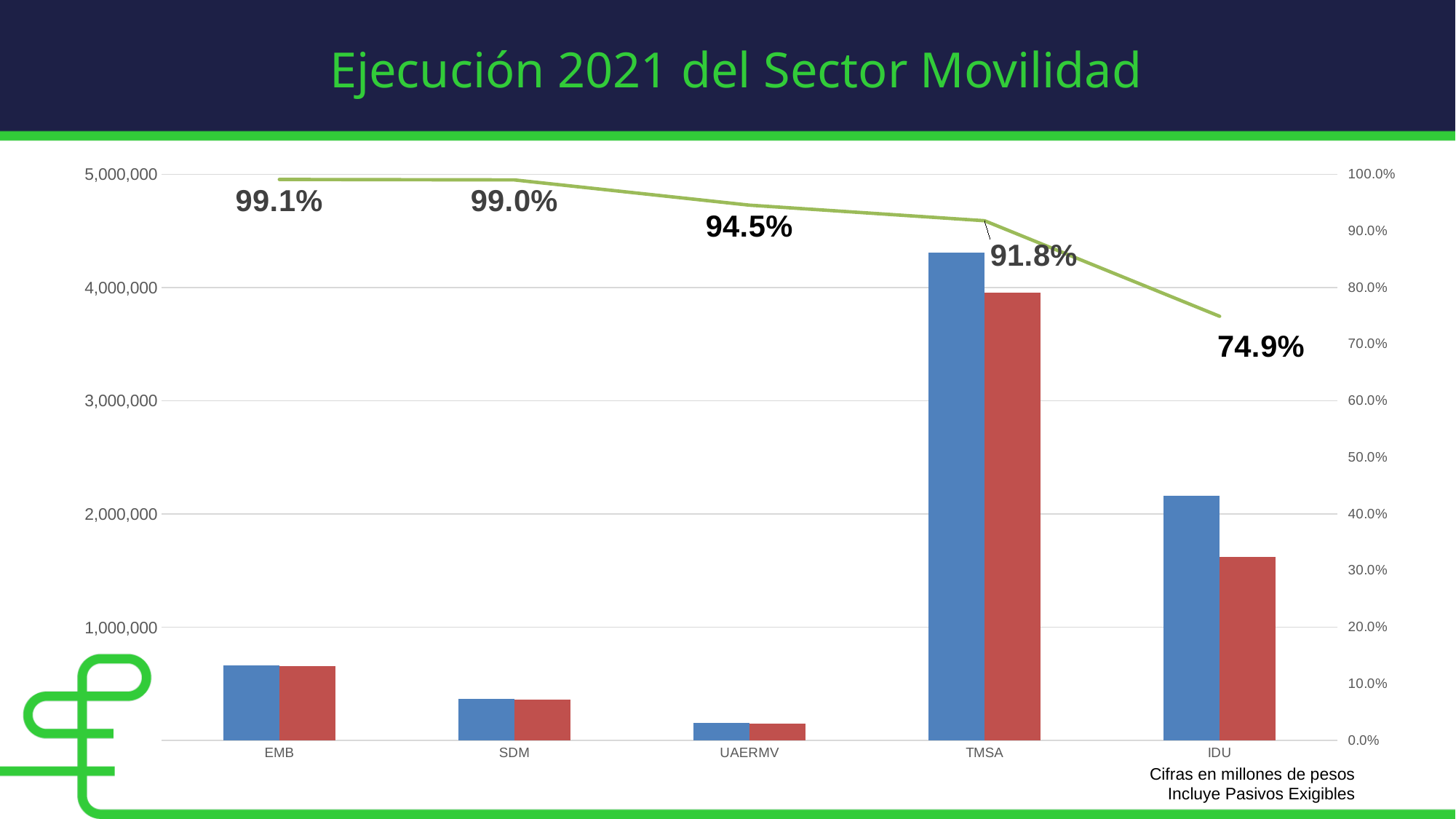
Which category has the lowest percentage on the line? IDU What is the difference in percentage points between EMB (99.1%) and IDU (74.9%)? 24.2 percentage points Do the percentages on the line rise or fall from EMB to IDU? fall Is the blue bar for TMSA greater or less than 4,000,000? greater What is the percentage shown for UAERMV on the line? 94.5% What is the percentage shown for IDU on the line? 74.9% How many categories are shown on the x axis? 5 What is the percentage shown for EMB on the line? 99.1% Which category has the highest percentage on the line? EMB What is the title of the slide? Ejecución 2021 del Sector Movilidad Which category has the tallest blue bar? TMSA What is the percentage shown for TMSA on the line? 91.8%